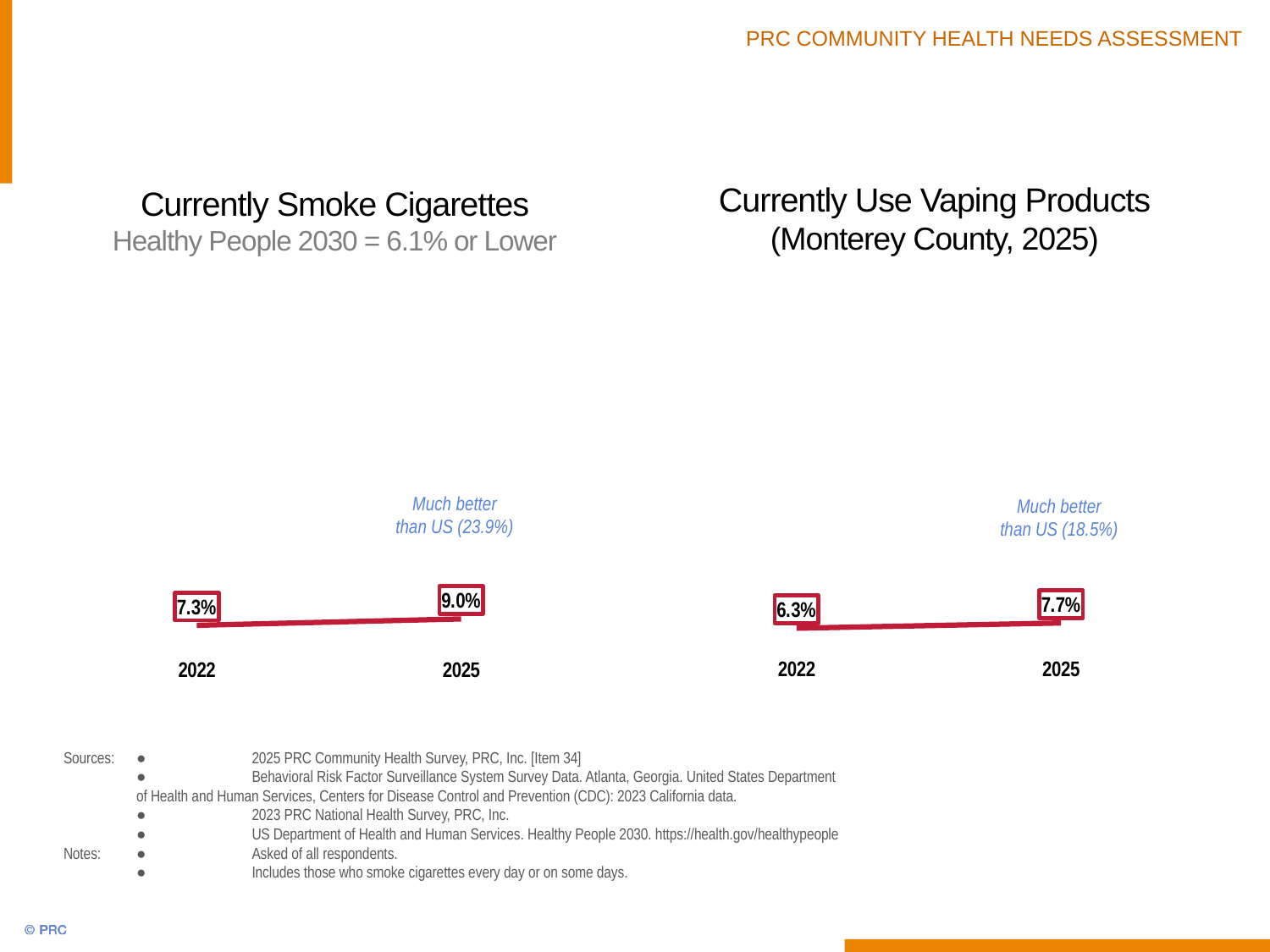
In the 'Currently Use Vaping Products' chart, what is the value for 2025? 7.7% In the 'Currently Use Vaping Products' chart, what is the difference between the 2025 and 2022 values? 1.4% How many data points are plotted in the 'Currently Use Vaping Products' chart? 2 In the 'Currently Smoke Cigarettes' chart, which year has the higher value? 2025 In the 'Currently Smoke Cigarettes' chart, do the values rise or fall from 2022 to 2025? rise What type of chart is the 'Currently Smoke Cigarettes' chart? line chart In the 'Currently Use Vaping Products' chart, which year has the lower value? 2022 In the 'Currently Smoke Cigarettes' chart, what is the difference between the 2025 and 2022 values? 1.7% In the 'Currently Smoke Cigarettes' chart, what is the value for 2022? 7.3% In the 'Currently Use Vaping Products' chart, what is the value for 2022? 6.3% Is the 2025 value in the 'Currently Smoke Cigarettes' chart larger or smaller than the 2025 value in the 'Currently Use Vaping Products' chart? larger In the 'Currently Smoke Cigarettes' chart, what is the value for 2025? 9.0%